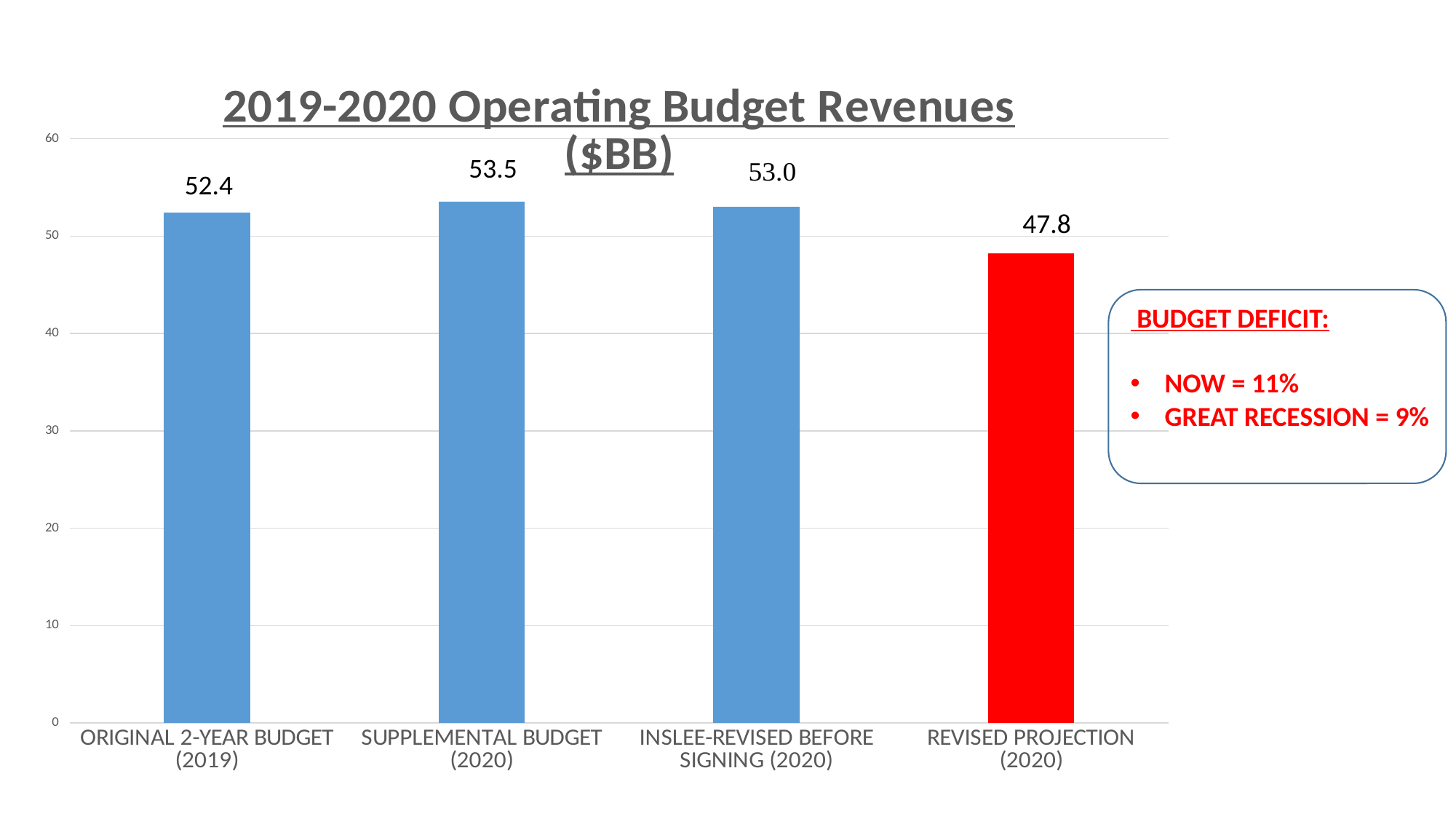
What kind of chart is shown on the slide? Bar chart Which category has the highest value? Supplemental Budget (2020) What is the value for Revised Projection (2020)? 47.8 What is the value for Original 2-Year Budget (2019)? 52.4 Is the value for Revised Projection (2020) greater or less than 50? less How many categories are shown in the chart? 4 What is the title of the chart? 2019-2020 Operating Budget Revenues ($BB) Which category has the lowest value? Revised Projection (2020) Which is larger, Original 2-Year Budget (2019) or Inslee-Revised Before Signing (2020)? Inslee-Revised Before Signing (2020) What is the difference between the Supplemental Budget (2020) and the Revised Projection (2020)? 5.7 What is the value for Inslee-Revised Before Signing (2020)? 53.0 What is the value for Supplemental Budget (2020)? 53.5